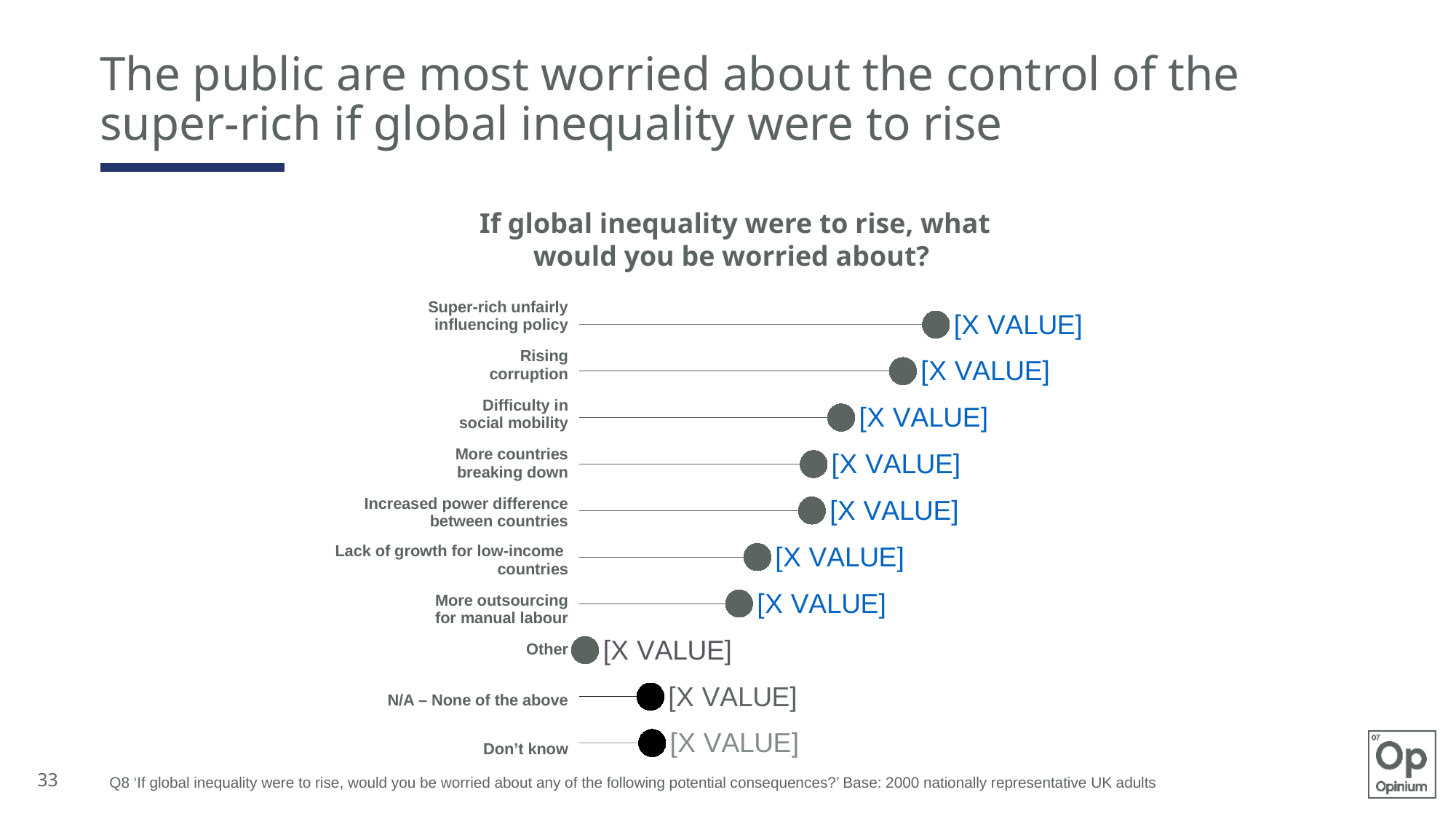
Which category has the second-highest value in the chart? Rising corruption Which is larger: the value for Lack of growth for low-income countries or the value for More outsourcing for manual labour? Lack of growth for low-income countries Which category has the lowest value in the chart? Other How many categories are plotted in the chart? 10 Which is larger: the value for Rising corruption or the value for Difficulty in social mobility? Rising corruption Which category has the highest value in the chart? Super-rich unfairly influencing policy Which is larger: the value for Super-rich unfairly influencing policy or the value for More countries breaking down? Super-rich unfairly influencing policy What kind of chart is shown on the slide? lollipop chart What is the title of the chart? If global inequality were to rise, what would you be worried about? Which category is listed at the bottom of the chart? Don't know Do the values generally rise or fall going down the list of categories from top to bottom? fall